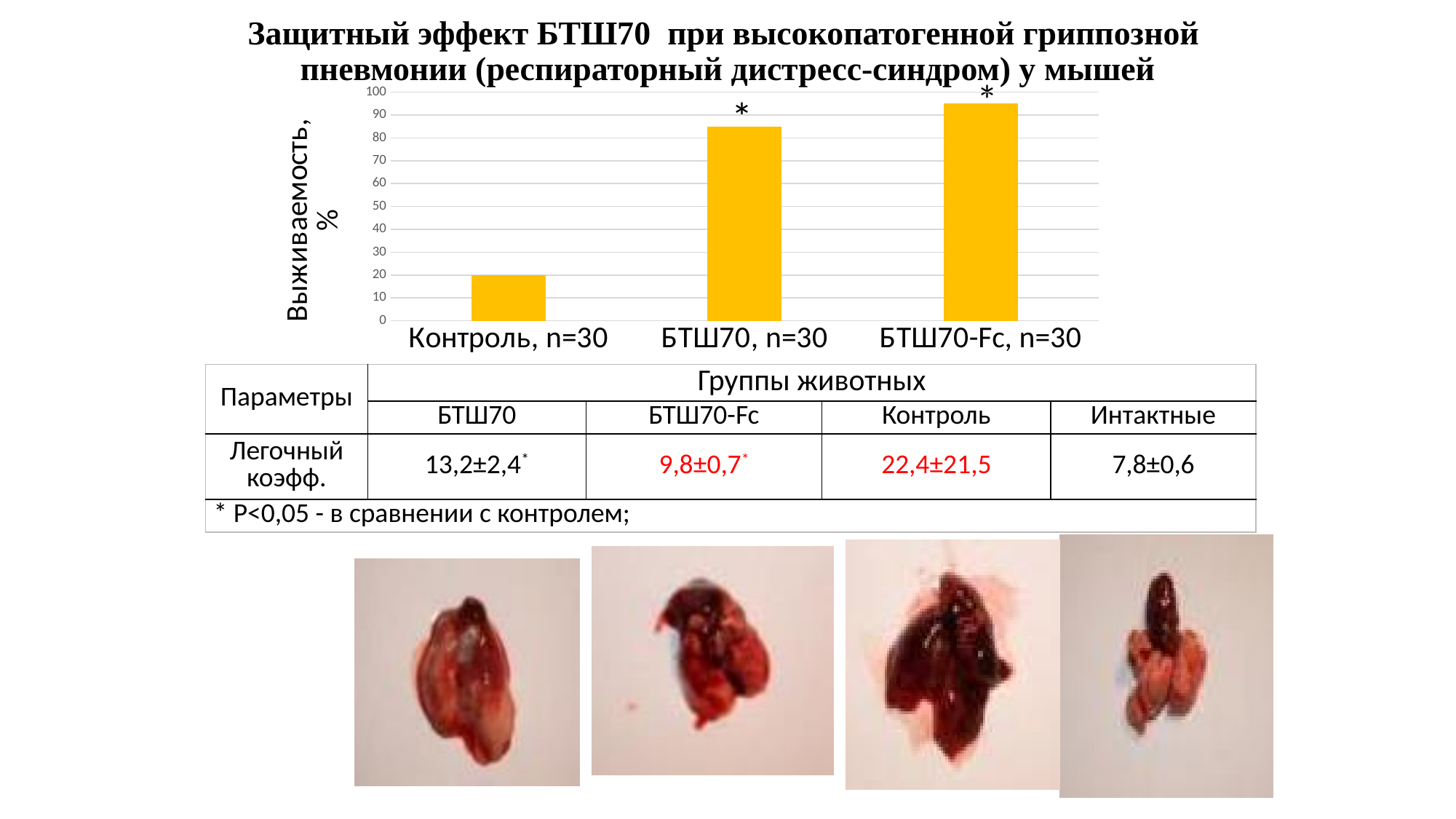
What is the label of the vertical axis of the bar chart? Выживаемость, % Is the value for БТШ70, n=30 greater or less than 80? greater How many categories are plotted in the bar chart? 3 Do the bar values rise or fall from left to right along the x axis? rise Which category has the highest survival in the bar chart? БТШ70-Fc, n=30 Which is larger in the bar chart: the value for БТШ70, n=30 or for Контроль, n=30? БТШ70, n=30 What is the survival value for Контроль, n=30 in the bar chart? 20 What kind of chart is shown on the slide? bar chart Which bars in the chart are marked with an asterisk? БТШ70, n=30 and БТШ70-Fc, n=30 Which category has the lowest survival in the bar chart? Контроль, n=30 Is the value for БТШ70-Fc, n=30 greater or less than 90? greater Is the value for Контроль, n=30 greater or less than 30? less